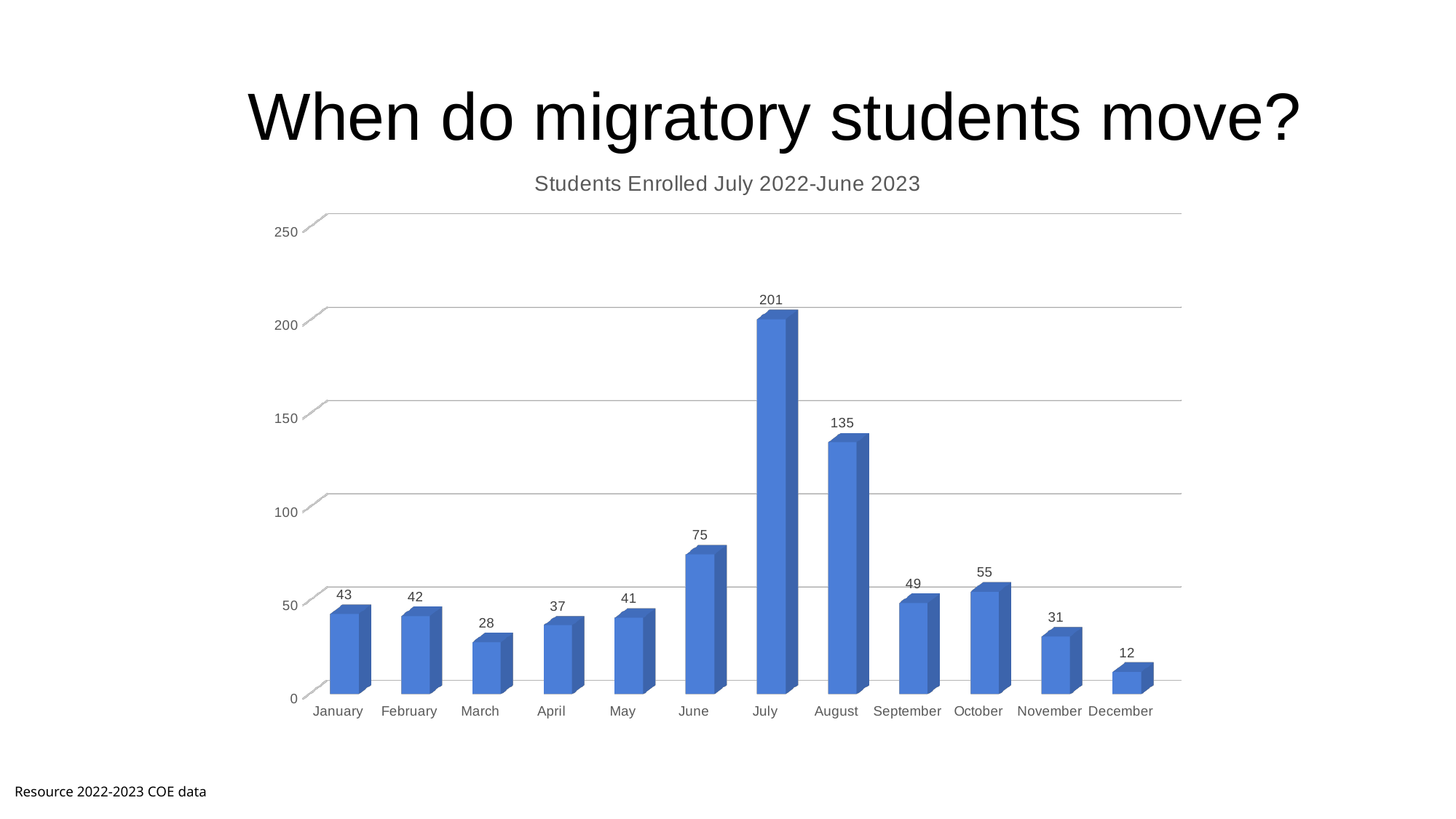
What is the difference between the values for July and August? 66 Which month has the lowest number of students enrolled? December What is the title of the chart? Students Enrolled July 2022-June 2023 What is the value for December? 12 Which is larger, the value for June or the value for October? June What is the value for August? 135 Which month has the highest number of students enrolled? July Do the values rise or fall from September to December? Neither; they rise from September to October, then fall Is the value for August greater or less than 100? greater What kind of chart is shown on the slide? Bar chart How many months are shown on the x axis? 12 What is the value for July? 201